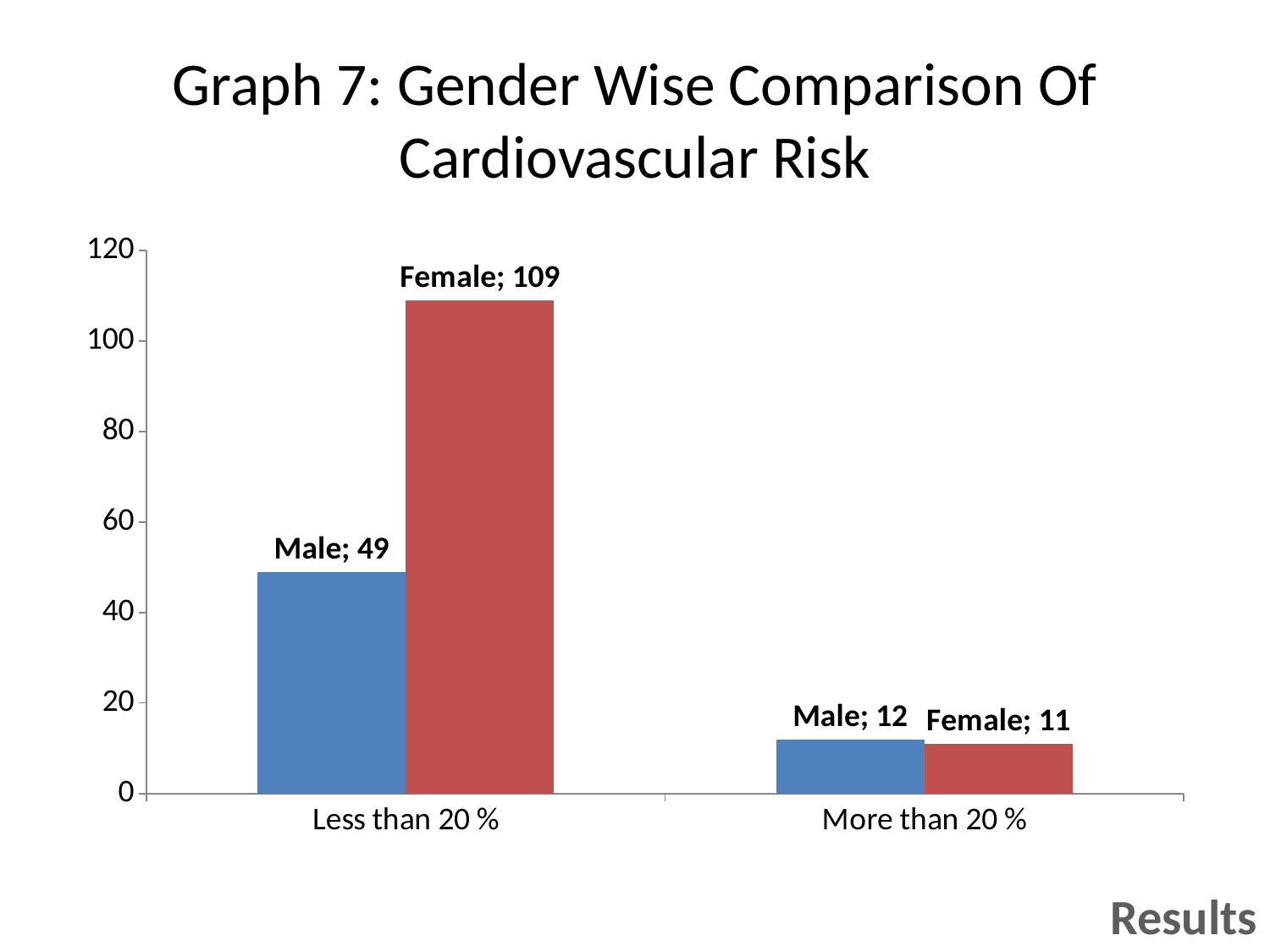
Is the Male value for 'Less than 20 %' greater or less than 40? greater What is the value for Female in the 'More than 20 %' category? 11 How many categories are shown on the x axis? 2 What kind of chart is shown on the slide? Bar chart In the 'Less than 20 %' category, which is larger, the Male value or the Female value? Female What is the difference between the Male values for 'Less than 20 %' and 'More than 20 %'? 37 Which bar has the highest value on the chart? Female, Less than 20 % What is the difference between the Female and Male values in the 'Less than 20 %' category? 60 What is the value for Male in the 'Less than 20 %' category? 49 What is the title of the chart? Graph 7: Gender Wise Comparison Of Cardiovascular Risk What is the value for Male in the 'More than 20 %' category? 12 What is the value for Female in the 'Less than 20 %' category? 109